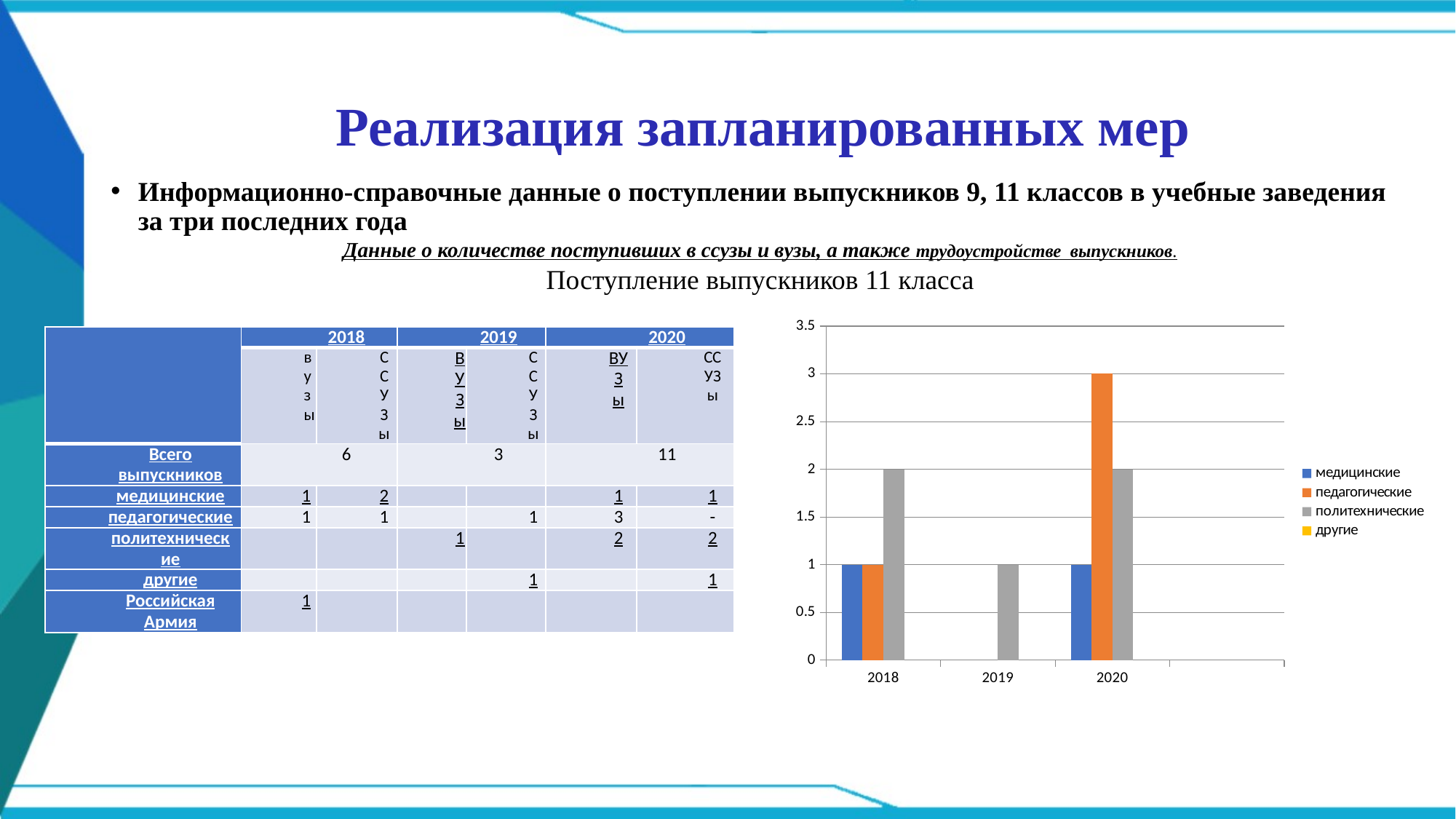
What is the value of the политехнические bar for 2019? 1 Which legend entry is shown in orange? педагогические What kind of chart is shown on the slide? bar chart Is the value of the педагогические bar for 2020 greater or less than 2.5? greater Which is larger in 2020: the педагогические bar or the политехнические bar? педагогические In which year is the педагогические bar the highest? 2020 How many series does the chart legend list? 4 What is the value of the политехнические bar for 2018? 2 What is the difference between the педагогические bar for 2020 and the педагогические bar for 2018? 2 How many year categories are shown on the x axis of the chart? 3 What is the value of the медицинские bar for 2020? 1 What is the value of the педагогические bar for 2020? 3